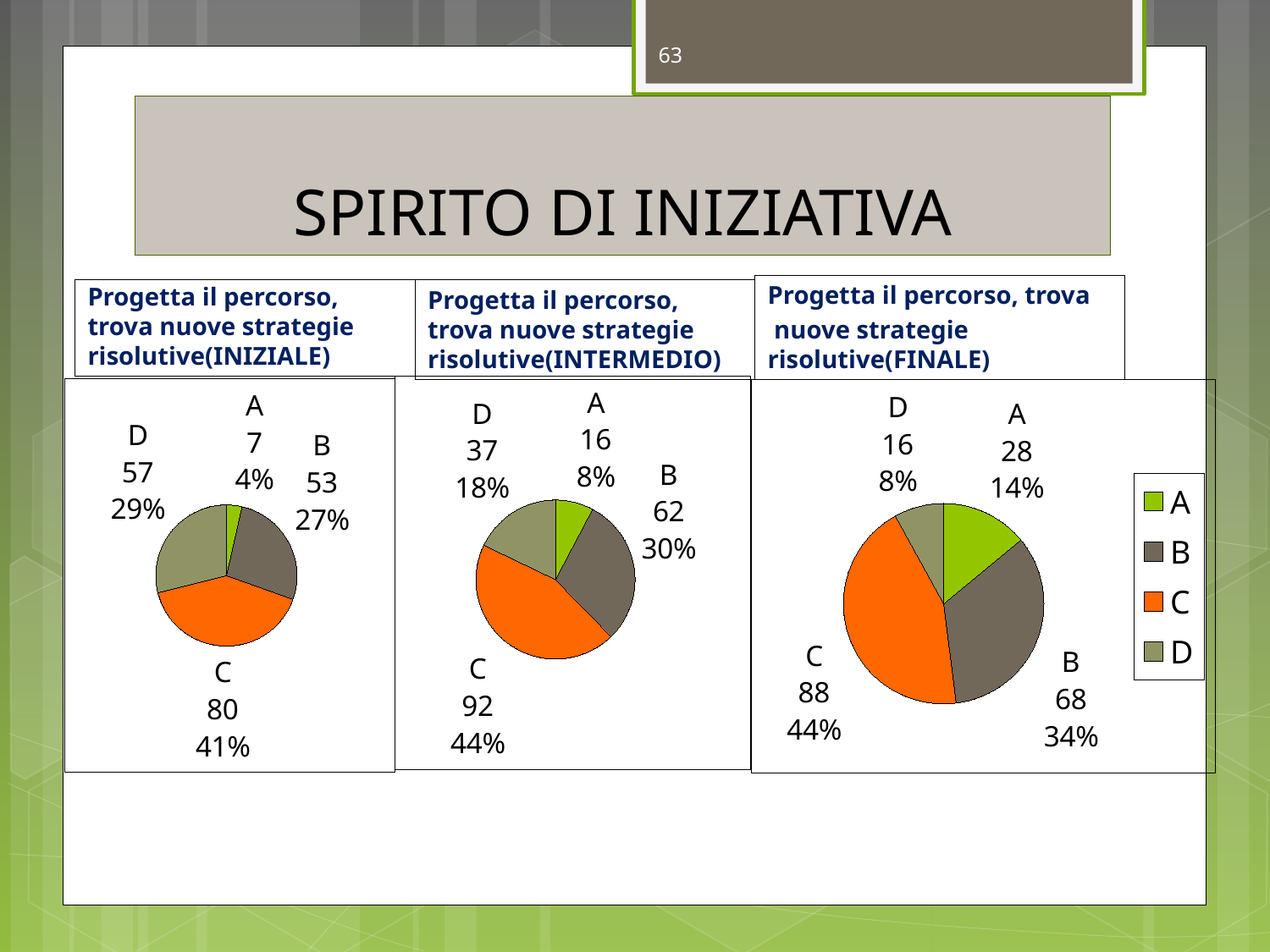
In the FINALE pie chart (right), which colour represents category C in the legend? Orange What kind of chart is used in the INIZIALE chart (left)? Pie chart In the FINALE pie chart (right), what is the value for category C? 88 In the INIZIALE pie chart (left), which category has the smallest value? A In the INTERMEDIO pie chart (middle), which category has the largest value? C In the INTERMEDIO pie chart (middle), what is the difference between the values for C and B? 30 In the FINALE pie chart (right), what share of the pie does category A have? 14% How many categories does the FINALE pie chart (right) show? 4 In the INIZIALE pie chart (left), what is the value for category C? 80 In the INIZIALE pie chart (left), what share of the pie does category D have? 29% In the FINALE pie chart (right), which is larger, the value for B or the value for D? B In the INTERMEDIO pie chart (middle), what is the value for category B? 62